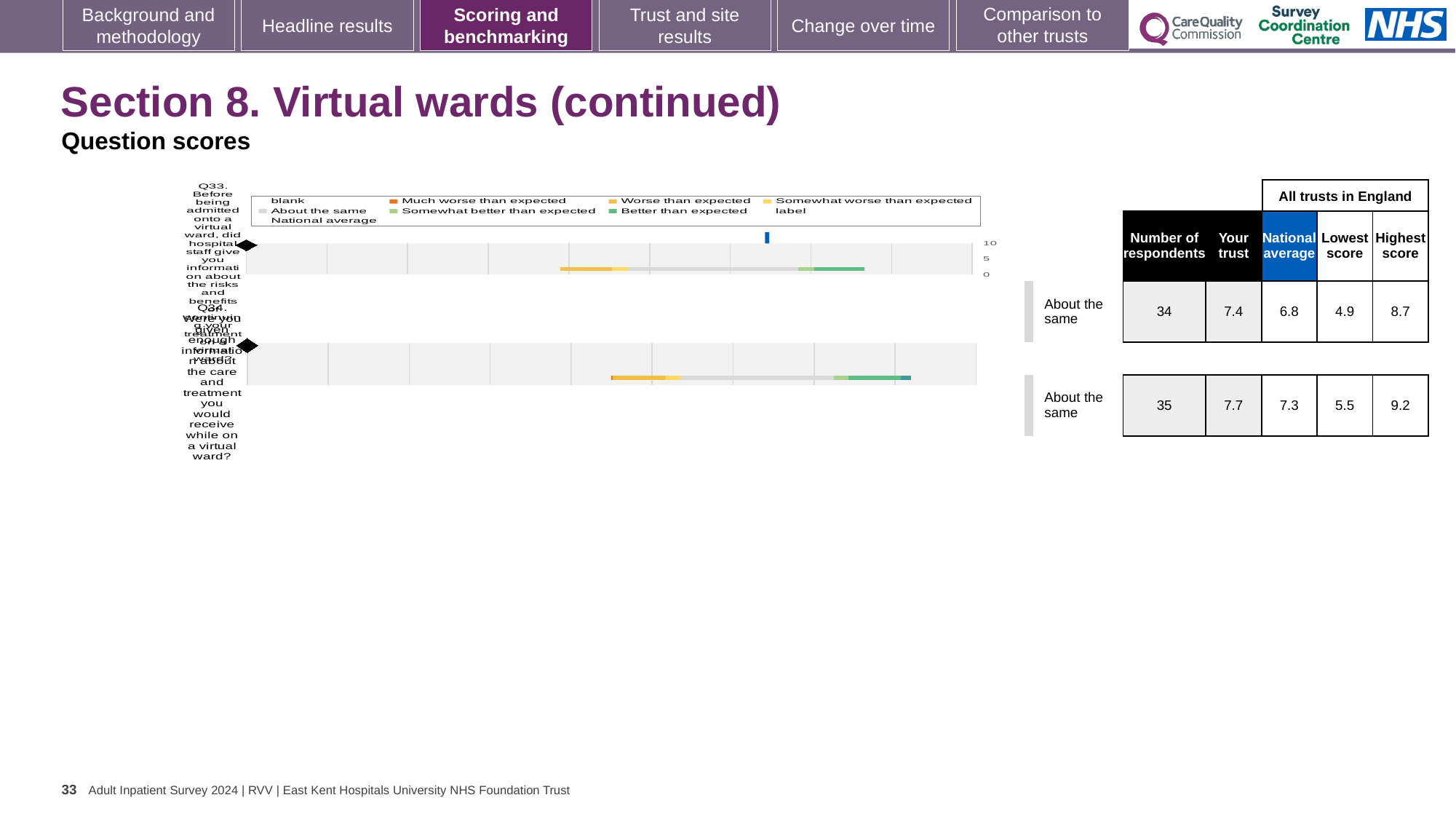
What is the lowest score among all trusts in England for Q33? 4.9 Which question has the higher 'Your trust' score, Q33 or Q34? Q34 How many respondents answered Q33? 34 What benchmark category is shown for Q34? About the same What is the highest score among all trusts in England for Q34? 9.2 By how much does the 'Your trust' score for Q33 exceed the national average? 0.6 What is the 'Your trust' score for Q33? 7.4 How many questions are plotted in the chart? 2 What is the difference between the highest and lowest scores for Q34? 3.7 What kind of chart is used to show the question scores for Q33 and Q34? bar chart For Q33, which is larger: the 'Your trust' score or the national average? Your trust What is the national average score for Q34? 7.3